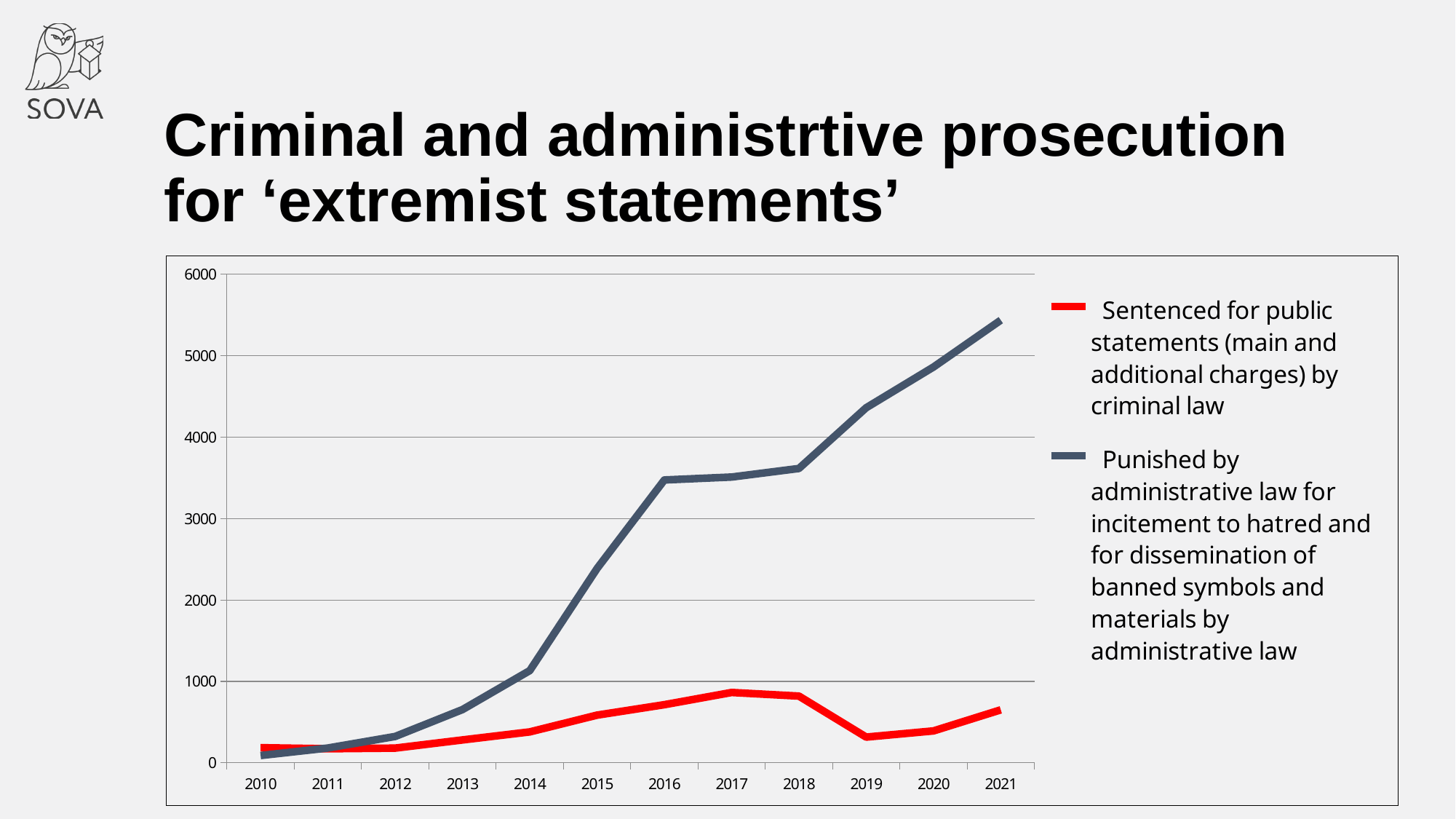
In which year does the 'Sentenced for public statements by criminal law' series reach its highest value? 2017 How many years are plotted along the x axis? 12 Which series has the larger value in 2021, 'Sentenced for public statements by criminal law' or 'Punished by administrative law'? Punished by administrative law Does the 'Punished by administrative law' series generally rise or fall from 2010 to 2021? Rise In which year is the value for 'Punished by administrative law' highest? 2021 Is the value for 'Sentenced for public statements by criminal law' in 2017 greater or less than 1000? less Is the value for 'Punished by administrative law' in 2016 greater or less than 3000? greater How many series does the legend list? 2 What kind of chart is shown on the slide? Line chart Is the value for 'Punished by administrative law' in 2021 greater or less than 5000? greater In which year is the value for 'Punished by administrative law' lowest? 2010 What colour is the line for 'Sentenced for public statements by criminal law'? Red